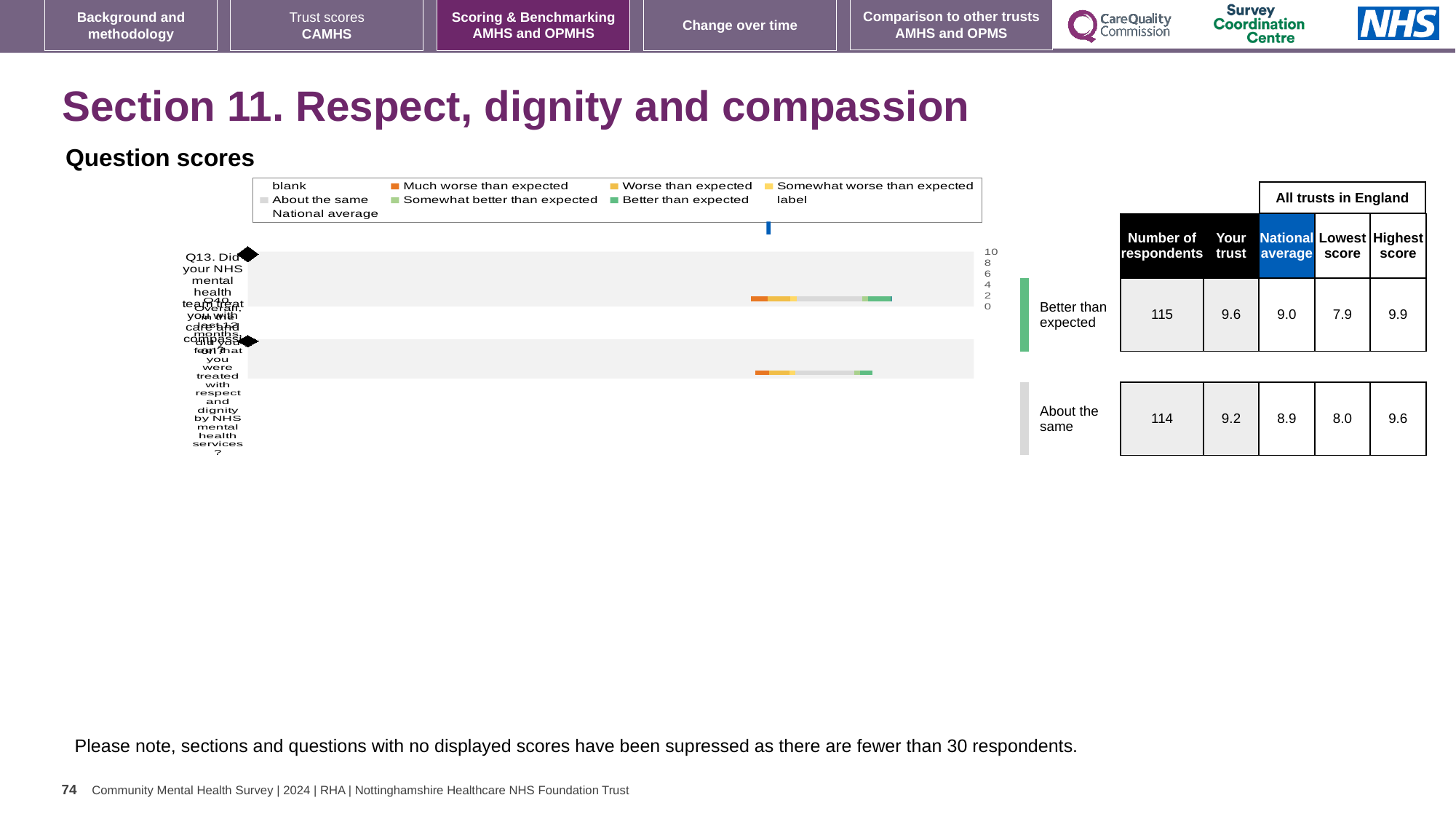
Which row has the higher 'Your trust' score, the one rated 'Better than expected' or the one rated 'About the same'? Better than expected What is the number of respondents for the row rated 'Better than expected'? 115 What kind of chart is shown under 'Question scores'? bar chart What is the difference between the 'Your trust' score and the national average for the row rated 'Better than expected'? 0.6 What is the lowest score across all trusts in England for the row rated 'Better than expected'? 7.9 What is the 'Your trust' score for the row rated 'About the same'? 9.2 What is the 'Your trust' score for the row rated 'Better than expected'? 9.6 What is the number of respondents for the row rated 'About the same'? 114 What is the highest score across all trusts in England for the row rated 'About the same'? 9.6 What is the national average for the row rated 'Better than expected'? 9.0 Which legend entry is shown in dark green in the Question scores chart? Better than expected How many question rows are plotted in the Question scores chart? 2